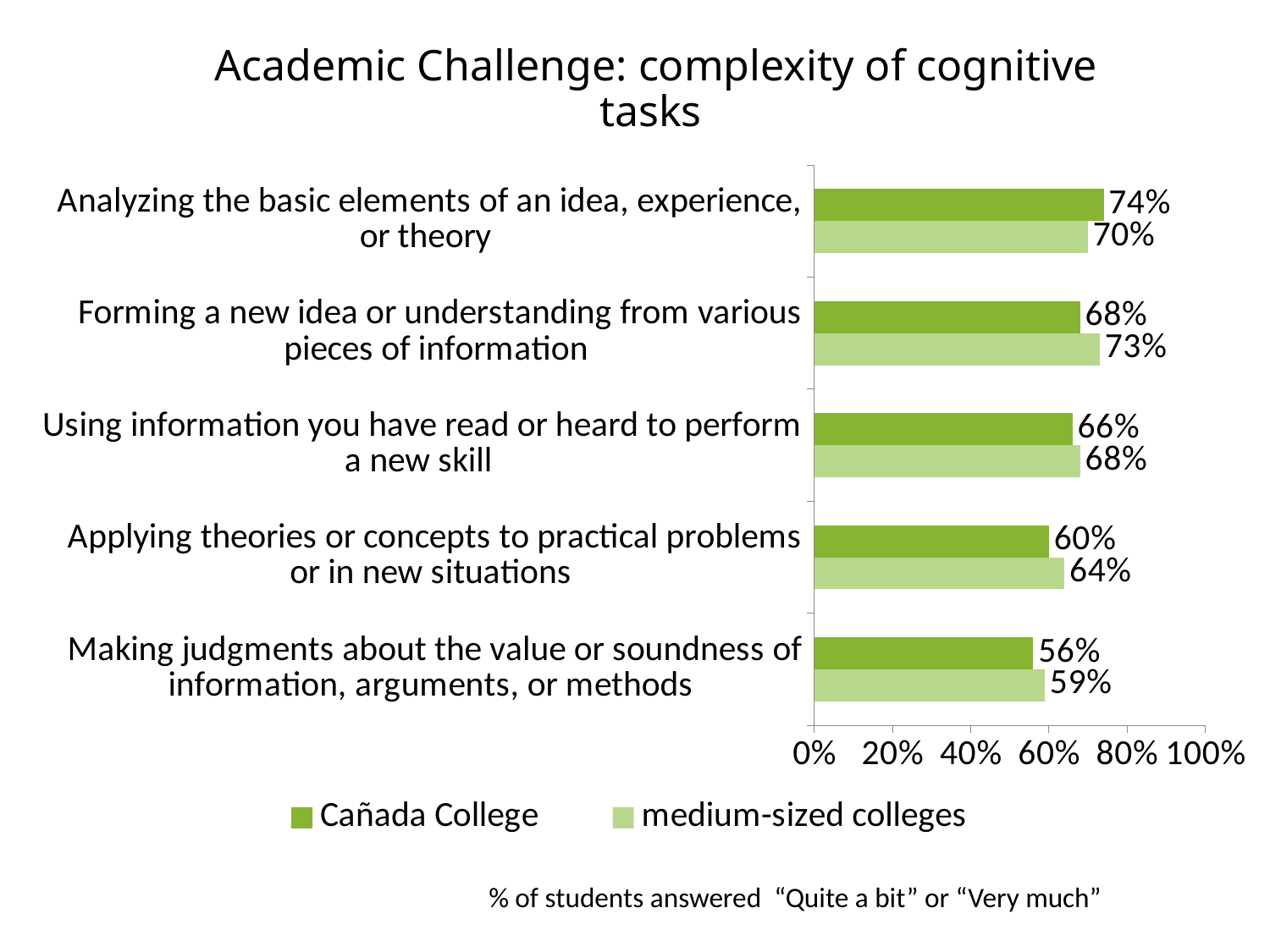
What is the Cañada College value for "Analyzing the basic elements of an idea, experience, or theory"? 74% What is the difference between the Cañada College and medium-sized colleges values for "Applying theories or concepts to practical problems or in new situations"? 4% What is the medium-sized colleges value for "Forming a new idea or understanding from various pieces of information"? 73% What is the title of the chart? Academic Challenge: complexity of cognitive tasks How many series does the legend list? 2 Which category has the highest Cañada College value? Analyzing the basic elements of an idea, experience, or theory Is the Cañada College value for "Using information you have read or heard to perform a new skill" greater or less than 60%? greater How many categories are shown on the chart? 5 What kind of chart is shown on the slide? bar chart Which category has the lowest medium-sized colleges value? Making judgments about the value or soundness of information, arguments, or methods For "Forming a new idea or understanding from various pieces of information", which is larger: Cañada College or medium-sized colleges? medium-sized colleges What is the Cañada College value for "Making judgments about the value or soundness of information, arguments, or methods"? 56%